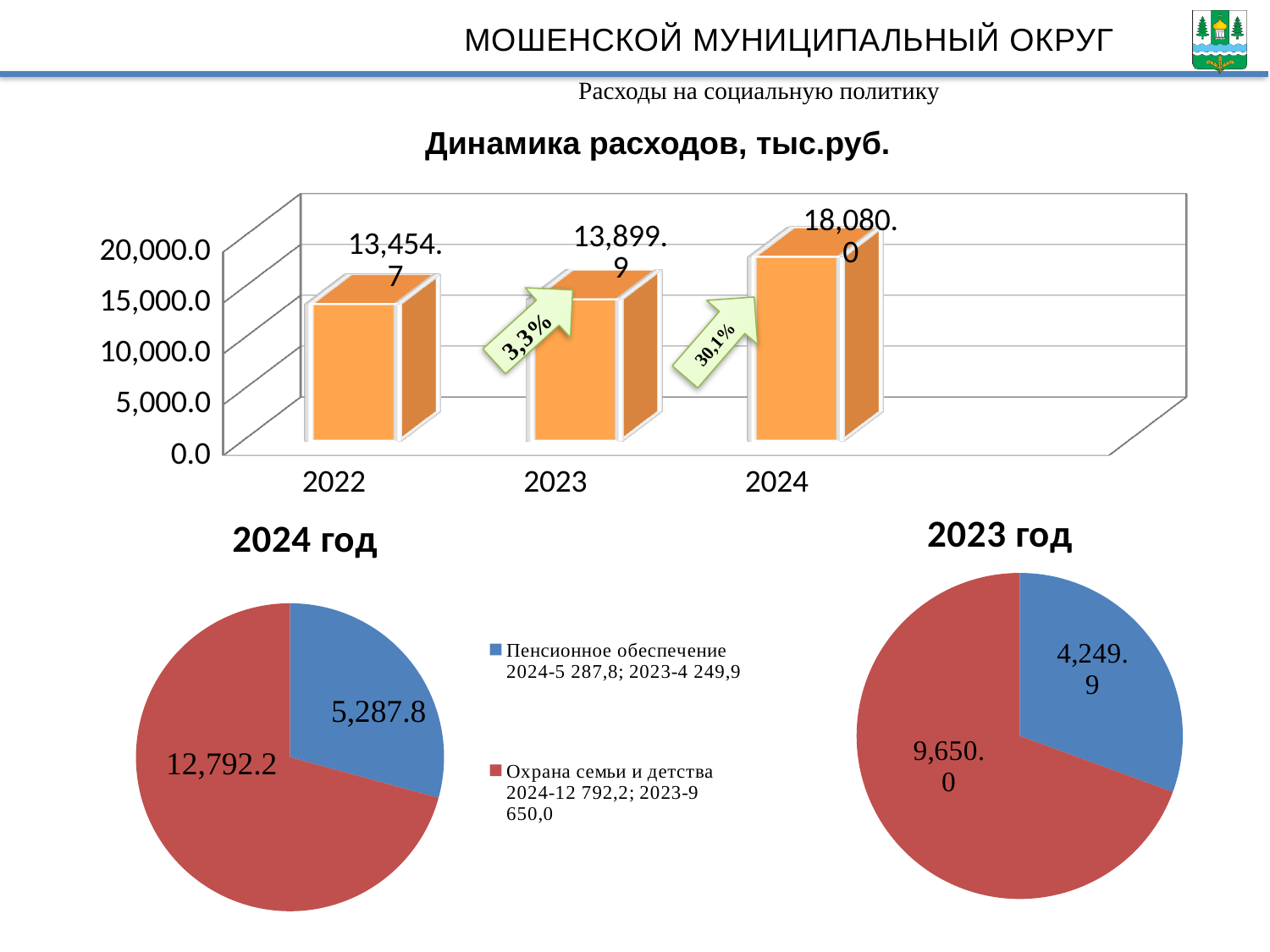
In the pie chart '2024 год', what is the value of the 'Пенсионное обеспечение' slice? 5,287.8 In the chart 'Динамика расходов, тыс.руб.', which year has the highest value? 2024 In the chart 'Динамика расходов, тыс.руб.', do the values rise or fall from 2022 to 2024? rise In the chart 'Динамика расходов, тыс.руб.', which year has the lowest value? 2022 In the chart 'Динамика расходов, тыс.руб.', how many years are shown on the x axis? 3 What kind of chart is 'Динамика расходов, тыс.руб.'? bar chart In the chart 'Динамика расходов, тыс.руб.', what is the value for 2024? 18,080.0 How many series does the legend between the two pie charts list? 2 In the chart 'Динамика расходов, тыс.руб.', what is the value for 2022? 13,454.7 In the pie chart '2023 год', what is the value of the 'Охрана семьи и детства' slice? 9,650.0 In the chart 'Динамика расходов, тыс.руб.', what is the difference between the 2024 and 2023 values? 4,180.1 In the pie chart '2024 год', which slice is larger: 'Пенсионное обеспечение' or 'Охрана семьи и детства'? Охрана семьи и детства